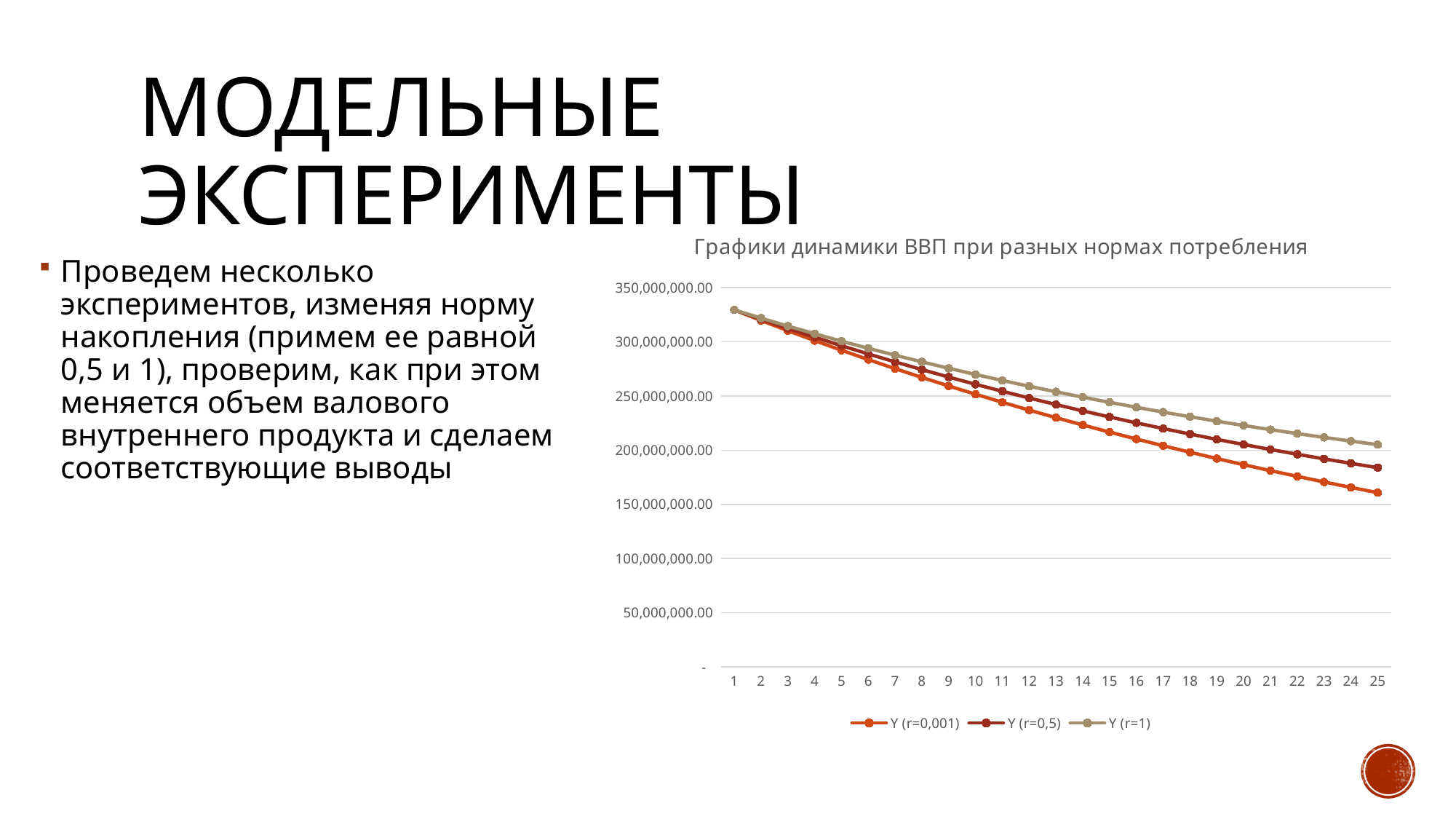
Which series has the lowest value at x = 25? Y (r=0,001) Do the values of the series Y (r=0,001) rise or fall as the x axis goes from 1 to 25? fall How many series does the chart legend list? 3 Which series has the highest value at x = 25? Y (r=1) Is the value of Y (r=0,001) at x = 25 greater or less than 200,000,000.00? less What is the title of the chart? Графики динамики ВВП при разных нормах потребления What kind of chart is shown on the slide? line chart Is the value of Y (r=0,5) at x = 1 greater or less than 300,000,000.00? greater What are the three series names listed in the chart legend? Y (r=0,001), Y (r=0,5), Y (r=1) Is the value of Y (r=1) at x = 25 greater or less than 200,000,000.00? greater At x = 25, which is larger: the value of Y (r=1) or the value of Y (r=0,001)? Y (r=1) How many points are plotted along the x axis for each series? 25